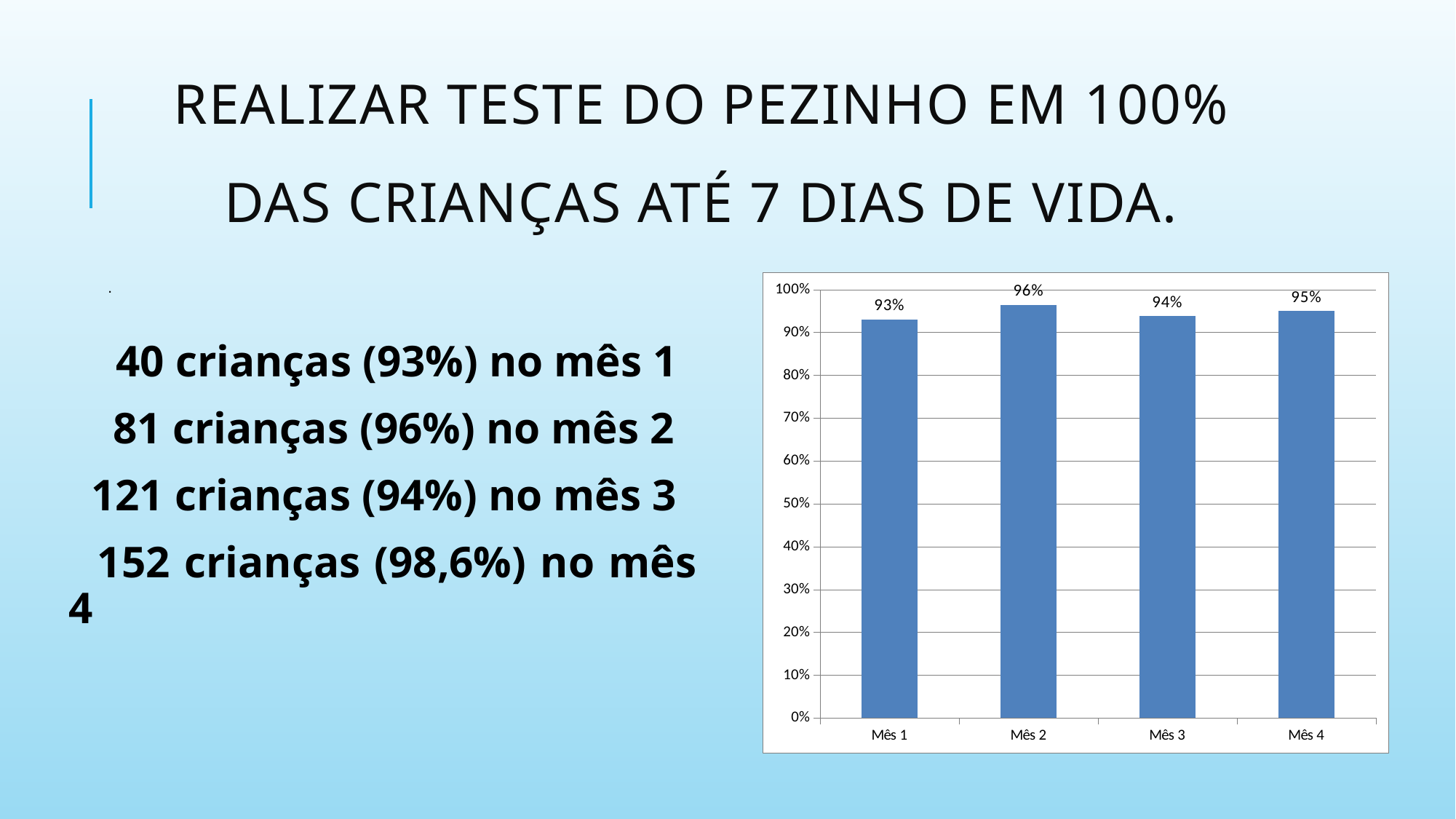
What is the difference between the values for Mês 2 and Mês 1? 3% What is the value for Mês 2? 96% Which month has the highest value? Mês 2 What is the value for Mês 4? 95% What is the highest tick value shown on the y axis? 100% What is the value for Mês 1? 93% Which month has the lowest value? Mês 1 What is the value for Mês 3? 94% What kind of chart is shown on the slide? bar chart Which is larger, the value for Mês 3 or the value for Mês 4? Mês 4 How many months are shown on the x axis? 4 Is the value for Mês 1 greater or less than 90%? greater